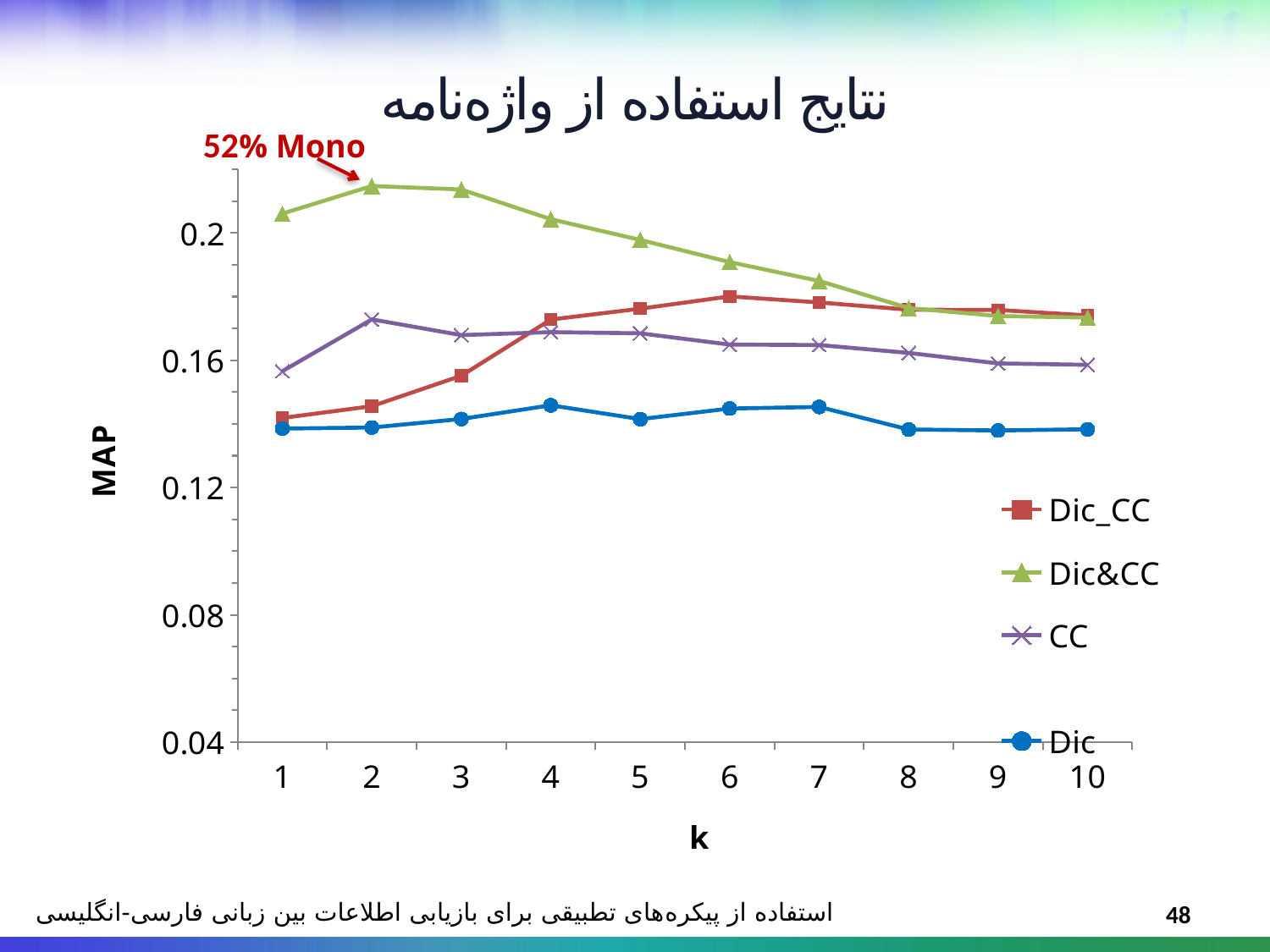
Does the MAP of the Dic&CC series rise or fall from k = 2 to k = 10? fall At k = 1, which series has the higher MAP, Dic_CC or CC? CC What kind of chart is shown on the slide? line chart Which series has the highest MAP at k = 2? Dic&CC Is the MAP value for Dic_CC at k = 6 greater or less than 0.16? greater How many series does the legend list? 4 Is the MAP value for Dic at k = 10 greater or less than 0.16? less How many values of k are plotted along the x axis? 10 Is the MAP value for Dic&CC at k = 2 greater or less than 0.2? greater At k = 6, which series has the higher MAP, Dic_CC or CC? Dic_CC Which series has the lowest MAP at k = 5? Dic What label is shown on the y axis of the chart? MAP